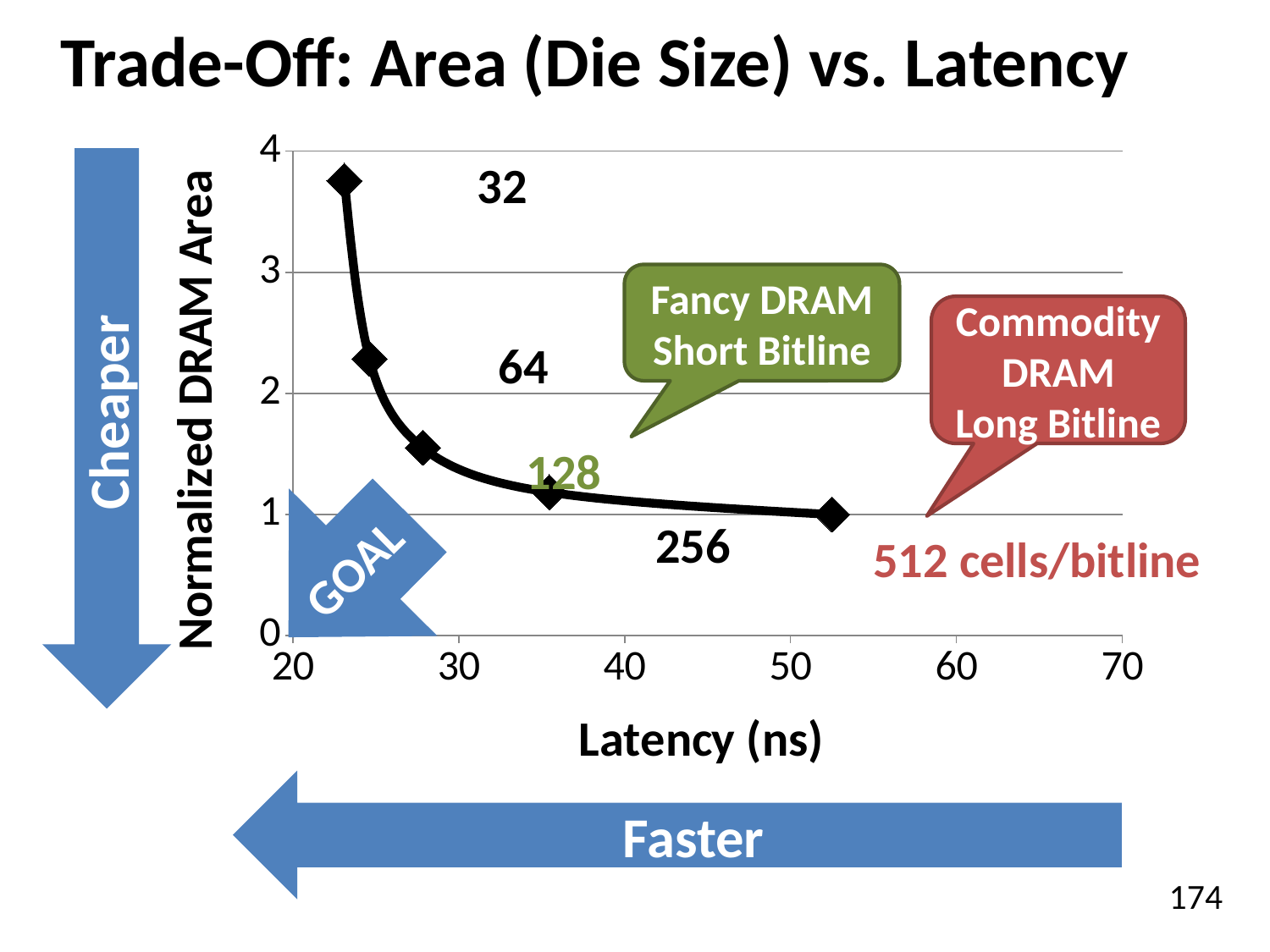
Is the normalized DRAM area for the 64 cells/bitline point greater or less than 2? greater Is the normalized DRAM area for the 32 cells/bitline point greater or less than 3? greater Which cells/bitline configuration has the highest normalized DRAM area? 32 What kind of chart is shown on the slide? line chart As latency increases along the x axis, does the normalized DRAM area rise or fall? fall What is the title of the slide's chart? Trade-Off: Area (Die Size) vs. Latency Is the latency for the 512 cells/bitline point greater or less than 50 ns? greater What is the label of the x axis? Latency (ns) Which has a larger normalized DRAM area, the 32 cells/bitline point or the 512 cells/bitline point? 32 How many data points are plotted on the curve? 5 Which cells/bitline configuration has the lowest normalized DRAM area? 512